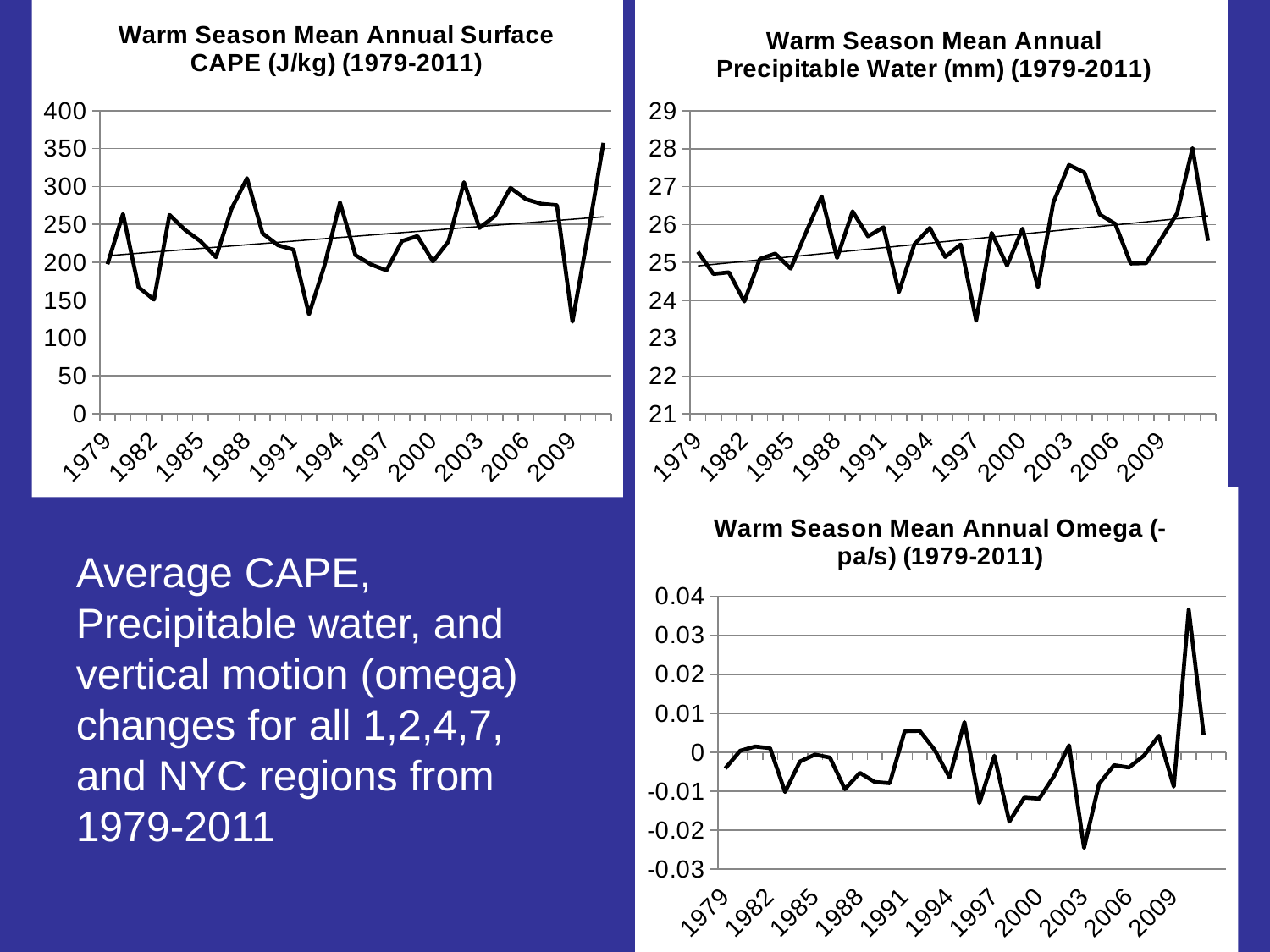
In the 'Warm Season Mean Annual Precipitable Water (mm)' chart, is the value for 1997 greater or less than 24? less In the 'Warm Season Mean Annual Surface CAPE' chart, is the value for 1992 greater or less than 150? less In the 'Warm Season Mean Annual Surface CAPE' chart, does the trend line rise or fall from 1979 to 2011? rise In the 'Warm Season Mean Annual Surface CAPE' chart, is the value for 2011 greater or less than 300? greater In the 'Warm Season Mean Annual Omega (-pa/s)' chart, which year has the highest value? 2010 In the 'Warm Season Mean Annual Surface CAPE' chart, which year has the highest CAPE value? 2011 In the 'Warm Season Mean Annual Precipitable Water (mm)' chart, which year has the lowest value? 1997 In the 'Warm Season Mean Annual Precipitable Water (mm)' chart, which year has the highest value? 2011 How many charts are shown on the slide? 3 What kind of chart is the 'Warm Season Mean Annual Surface CAPE (J/kg) (1979-2011)' chart? line chart In the 'Warm Season Mean Annual Precipitable Water (mm)' chart, does the trend line rise or fall over the period? rise